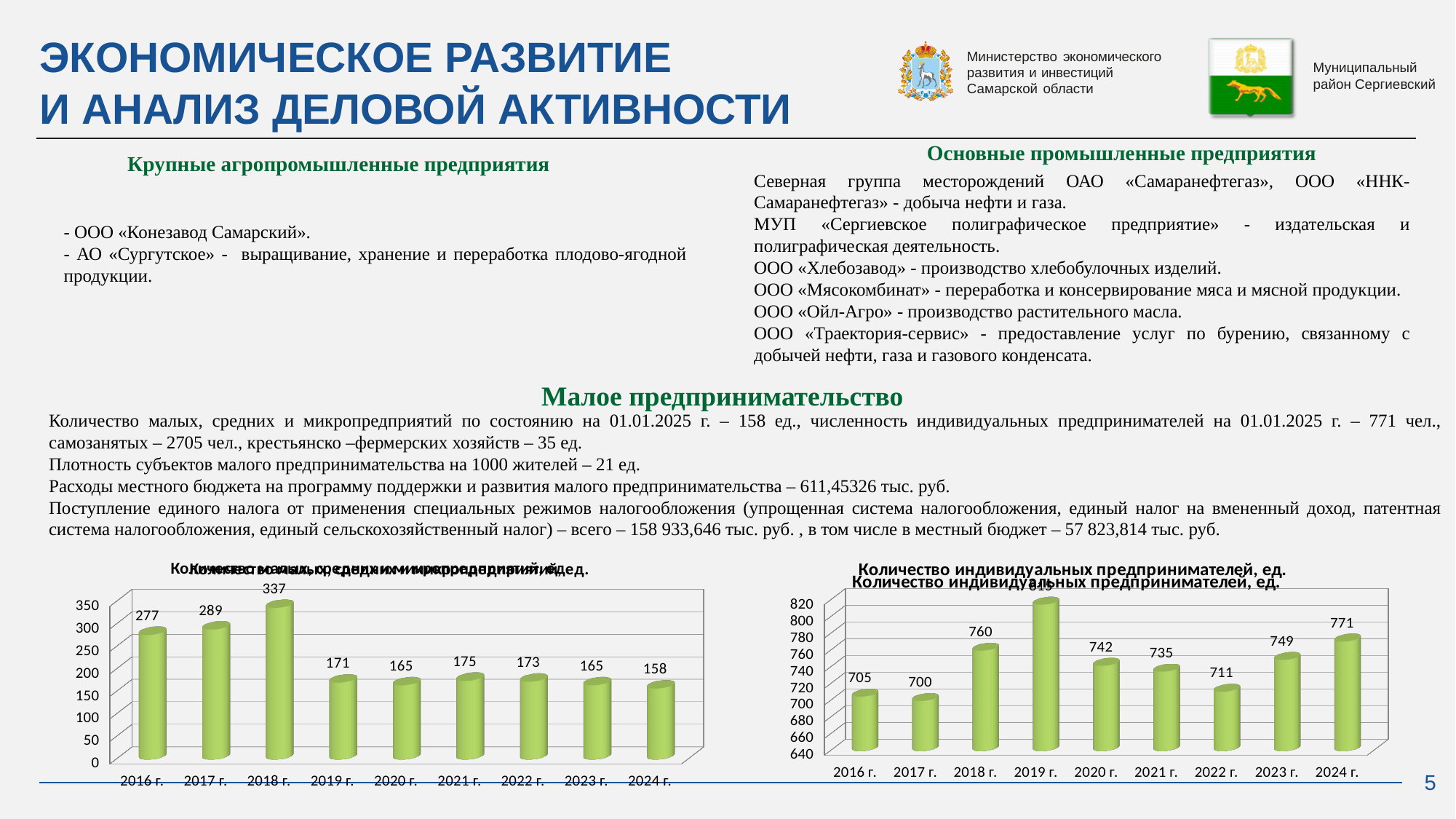
In the chart titled 'Количество индивидуальных предпринимателей, ед.', what is the value for 2017 г.? 700 In the chart titled 'Количество индивидуальных предпринимателей, ед.', what is the difference between the values for 2024 г. and 2022 г.? 60 In the left chart (number of small, medium and micro enterprises), what is the value for 2024 г.? 158 In the chart titled 'Количество индивидуальных предпринимателей, ед.', what is the value for 2019 г.? 815 In the left chart (number of small, medium and micro enterprises), what is the difference between the values for 2018 г. and 2019 г.? 166 In the left chart (number of small, medium and micro enterprises), how many years are shown on the x axis? 9 In the left chart (number of small, medium and micro enterprises), which year has the highest value? 2018 г. What type of chart is the chart titled 'Количество индивидуальных предпринимателей, ед.'? Bar chart In the chart titled 'Количество индивидуальных предпринимателей, ед.', which year has the lowest value? 2017 г. In the left chart (number of small, medium and micro enterprises), which year has the lowest value? 2024 г. In the left chart (number of small, medium and micro enterprises), what is the value for 2018 г.? 337 In the chart titled 'Количество индивидуальных предпринимателей, ед.', which is larger: the value for 2023 г. or the value for 2024 г.? 2024 г.